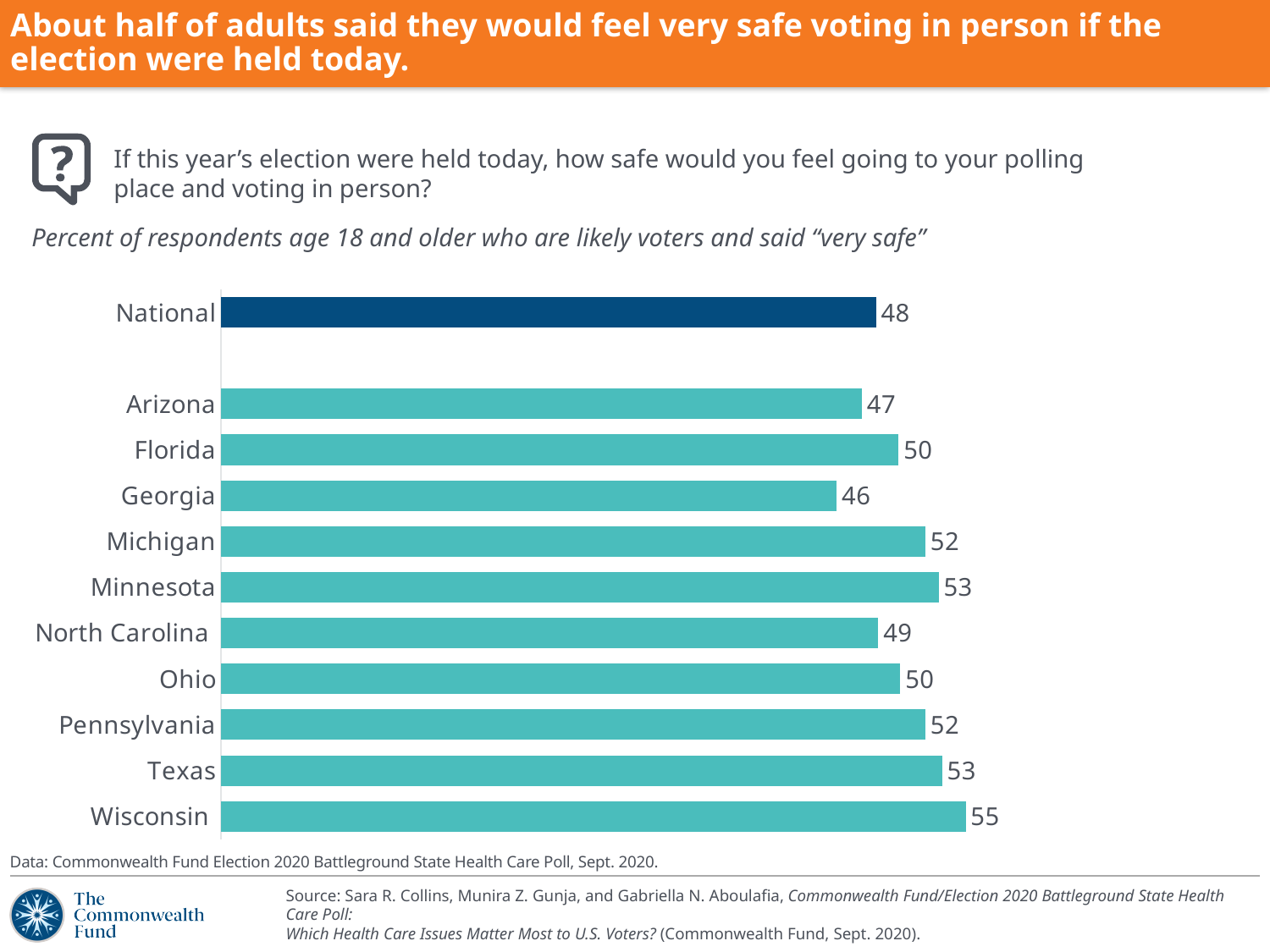
What kind of chart is shown on the slide? Bar chart What is the difference between the values for Wisconsin and Georgia? 9 Which state has the lowest value? Georgia Which is larger, the value for Michigan or the value for Arizona? Michigan How many states (excluding National) are shown in the chart? 10 What is the value for Wisconsin? 55 What is the value for Georgia? 46 What is the value for North Carolina? 49 What is the value for National? 48 Which bar is shown in a darker blue colour than the others? National Which state has the highest value? Wisconsin What is the difference between the values for Minnesota and National? 5